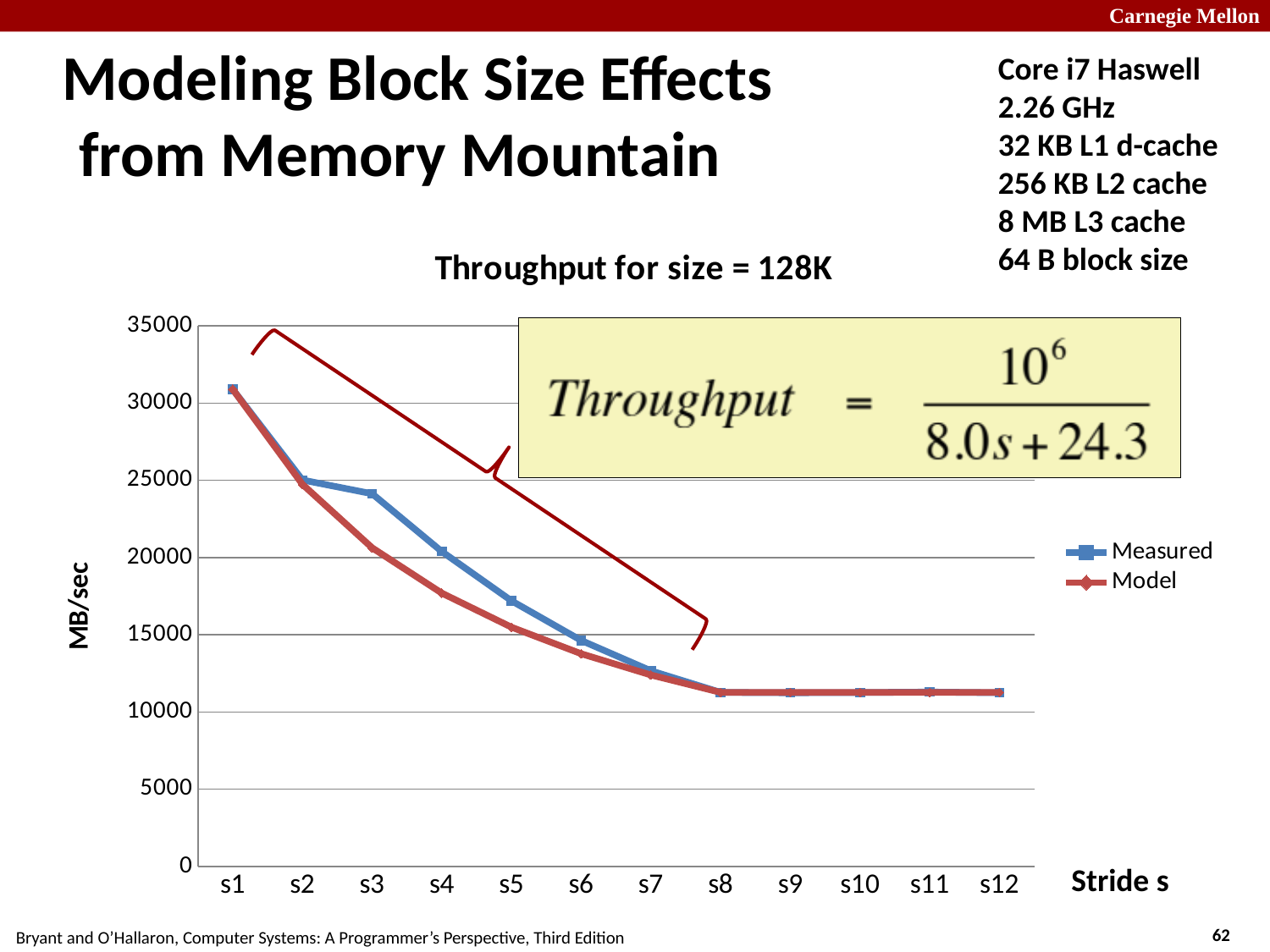
Is the Model value at s4 greater or less than 20000? less Is the Measured value at s12 greater or less than 15000? less Do the Measured values rise or fall from s1 to s8? fall How many series does the legend list? 2 What is the title of the chart? Throughput for size = 128K At stride s3, which series has the larger value, Measured or Model? Measured Is the Measured value at s1 greater or less than 30000? greater At which stride is the Measured throughput highest? s1 How many stride values are plotted along the x axis? 12 What is the label on the y axis of the chart? MB/sec What kind of chart is shown on the slide? line chart